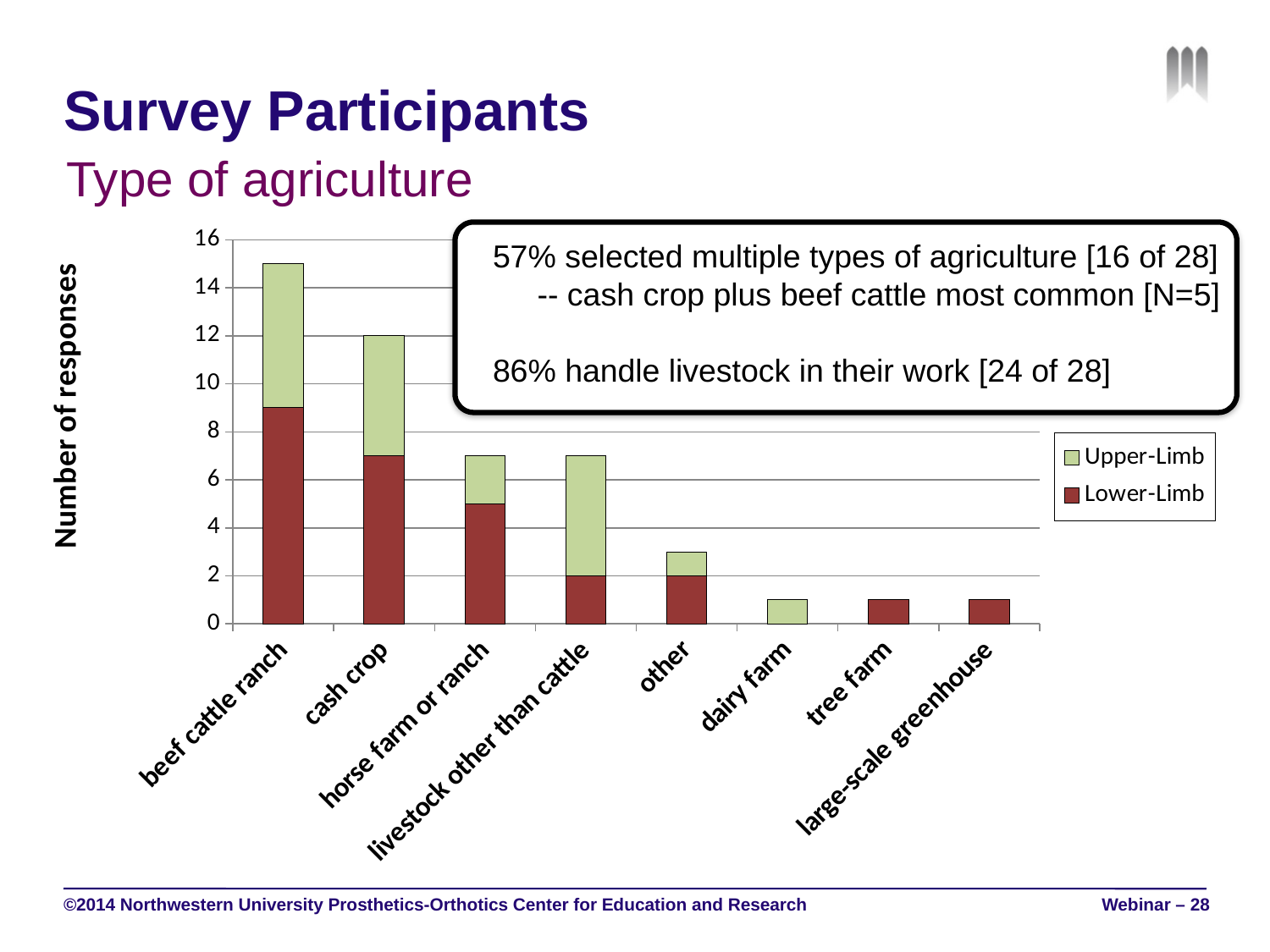
What kind of chart is shown on the slide? Stacked bar chart How many types of agriculture are shown on the x axis of the chart? 8 Which has more total responses, cash crop or horse farm or ranch? cash crop Do the total responses rise or fall moving from left to right along the x axis? fall Is the total number of responses for beef cattle ranch greater or less than 14? greater What is the Lower-Limb value for livestock other than cattle? 2 What is the total number of responses for cash crop? 12 Is the total number of responses for other greater or less than 4? less How many series does the chart's legend list? 2 What is the title of the y axis? Number of responses Which type of agriculture has the highest total number of responses? beef cattle ranch Is the total number of responses for horse farm or ranch greater or less than 6? greater